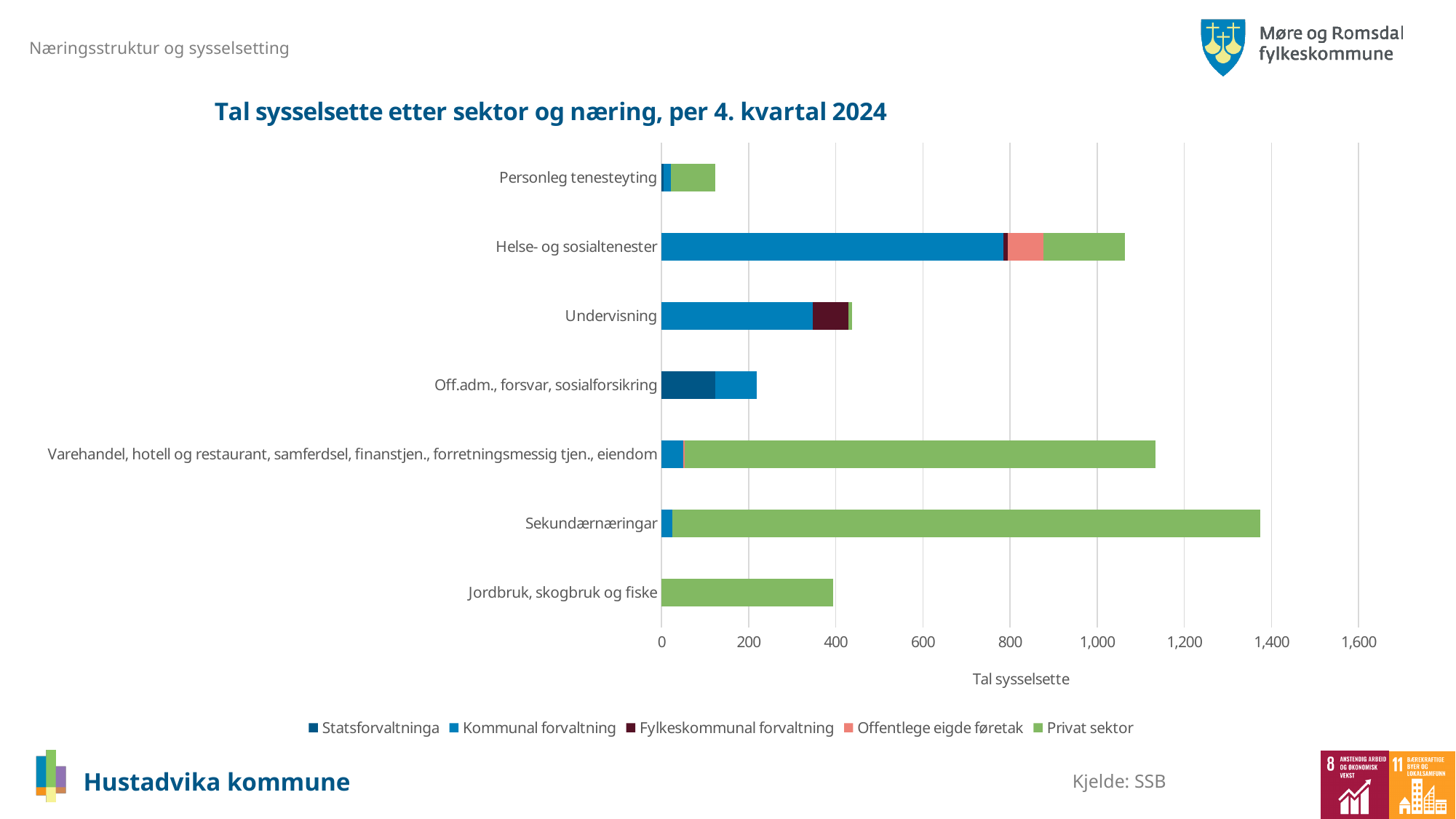
Which category has the shortest total bar? Personleg tenesteyting Is the total value for Sekundærnæringar greater or less than 1,200? greater Is the total value for Helse- og sosialtenester greater or less than 1,000? greater In which category is the Kommunal forvaltning segment the largest? Helse- og sosialtenester Which category has the longest total bar? Sekundærnæringar Which has the larger total bar: Sekundærnæringar or Helse- og sosialtenester? Sekundærnæringar How many industry categories are plotted on the chart? 7 What is the title of the chart? Tal sysselsette etter sektor og næring, per 4. kvartal 2024 How many series does the legend list? 5 Is the total value for Undervisning greater or less than 600? less What kind of chart is shown on the slide? Stacked bar chart